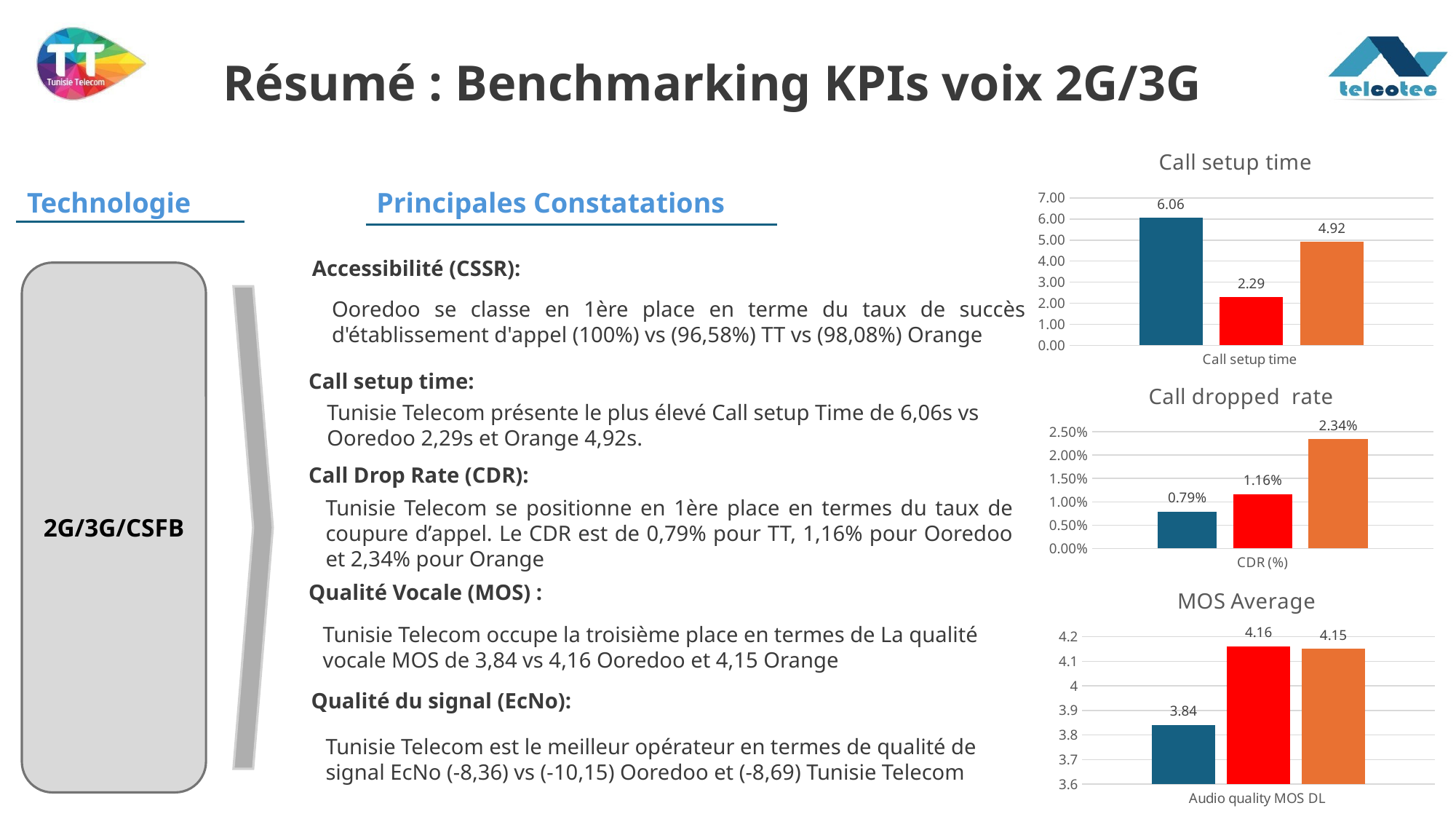
In the 'Call setup time' chart, what is the value of the red (middle) bar? 2.29 In the 'Call setup time' chart, what is the difference between the highest and lowest bars? 3.77 In the 'Call dropped rate' chart, what is the difference between the orange bar and the blue bar? 1.55% In the 'Call dropped rate' chart, what is the value of the orange (rightmost) bar? 2.34% In the 'Call dropped rate' chart, which bar is the lowest: the blue, red or orange one? blue In the 'Call setup time' chart, what is the value of the tallest (blue, leftmost) bar? 6.06 In the 'Call setup time' chart, how many bars are plotted? 3 In the 'MOS Average' chart, what is the value of the blue (leftmost) bar? 3.84 What type of chart is the 'MOS Average' chart? bar chart In the 'MOS Average' chart, which bar is the lowest: the blue, red or orange one? blue In the 'Call dropped rate' chart, is the value of the red bar greater or less than 1.00%? greater In the 'MOS Average' chart, what is the difference between the red bar and the blue bar? 0.32